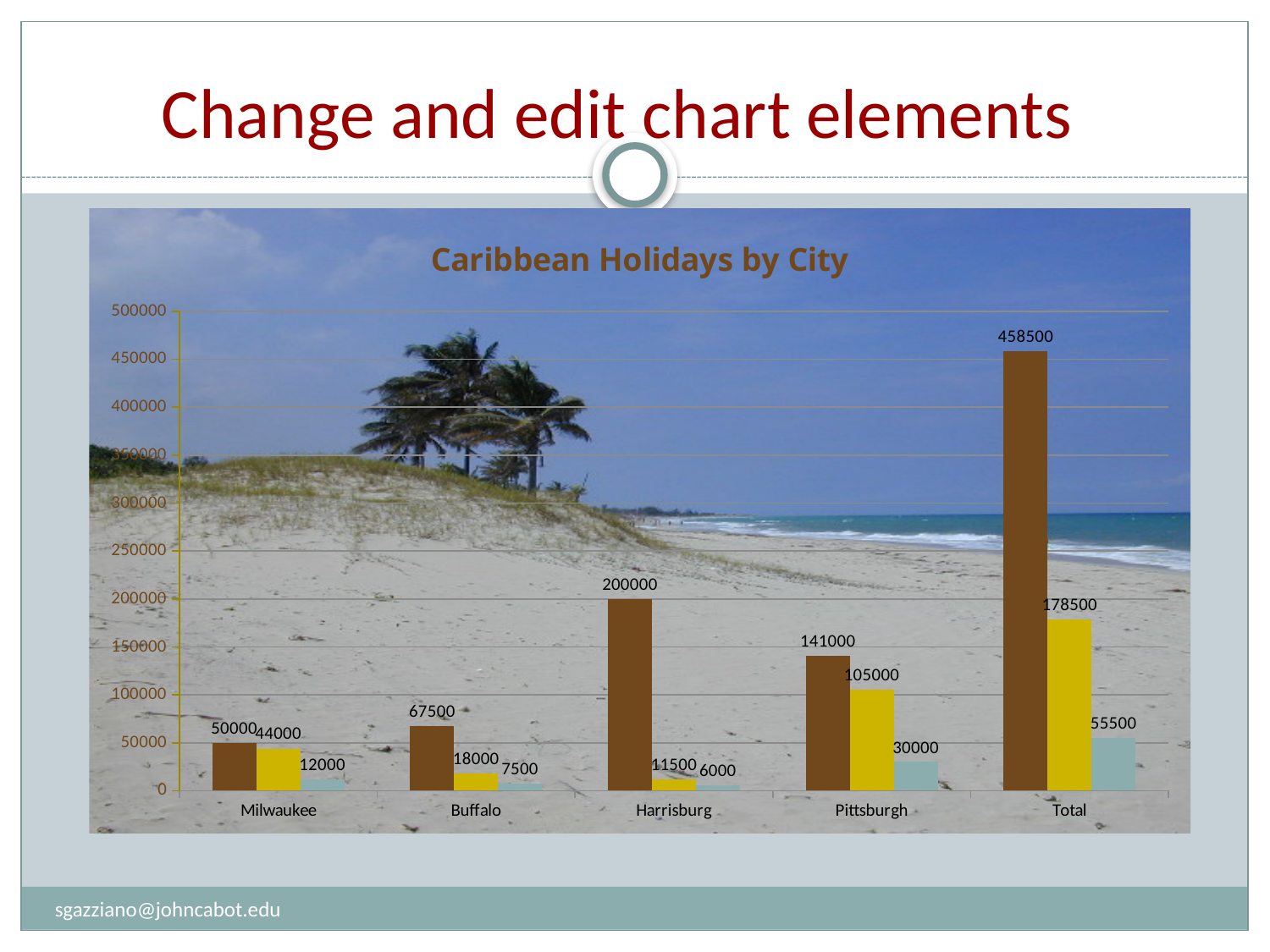
Among the individual cities (excluding Total), which city has the lowest light blue bar? Harrisburg What kind of chart is shown on the slide? bar chart What is the value of the brown bar for Harrisburg? 200000 What is the value of the yellow bar for Pittsburgh? 105000 What is the value of the brown bar for Total? 458500 Which is larger, the yellow bar for Buffalo or the yellow bar for Milwaukee? Milwaukee What is the title of the chart? Caribbean Holidays by City How many categories are shown on the x axis of the chart? 5 What is the value of the light blue bar for Milwaukee? 12000 Is the brown bar for Buffalo greater or less than 100000? less Among the individual cities (excluding Total), which city has the highest brown bar? Harrisburg What is the difference between the brown bar and the yellow bar for Pittsburgh? 36000